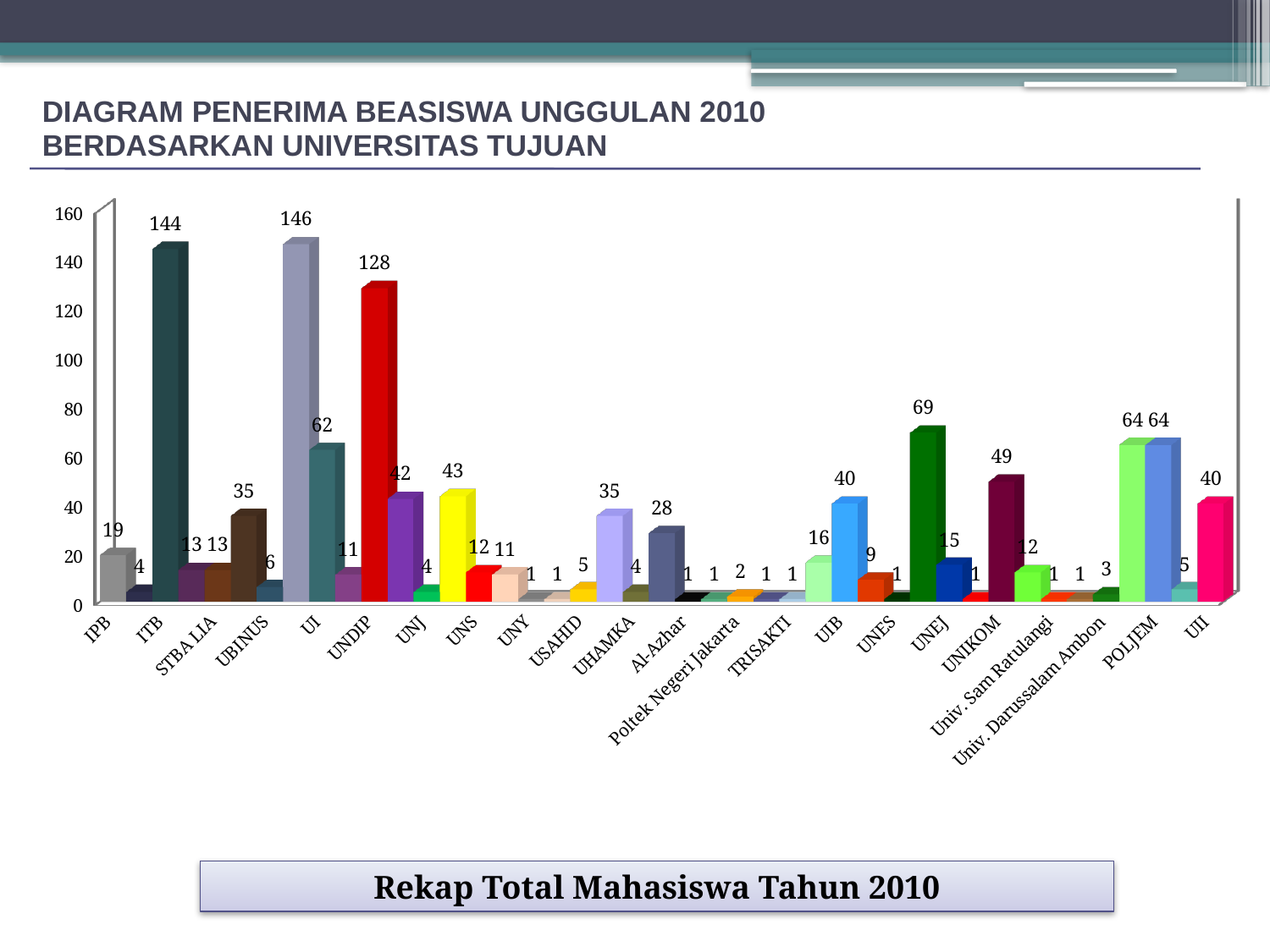
What is the highest value labelled on any bar in the chart? 146 What kind of chart is shown on the slide? bar chart What is the maximum value shown on the vertical axis? 160 How many university names are listed along the horizontal axis? 22 What is the difference between the bars labelled 69 and 49? 20 What is the difference between the two tallest bars, labelled 146 and 144? 2 How many bars in the chart have a value of 100 or more? 3 How many bars in the chart are labelled 64? 2 What is the title of the chart on the slide? DIAGRAM PENERIMA BEASISWA UNGGULAN 2010 BERDASARKAN UNIVERSITAS TUJUAN What is the lowest value labelled on any bar in the chart? 1 Which is larger, the bar labelled 144 or the bar labelled 128? 144 Which is larger, the bar labelled 62 or the bar labelled 43? 62